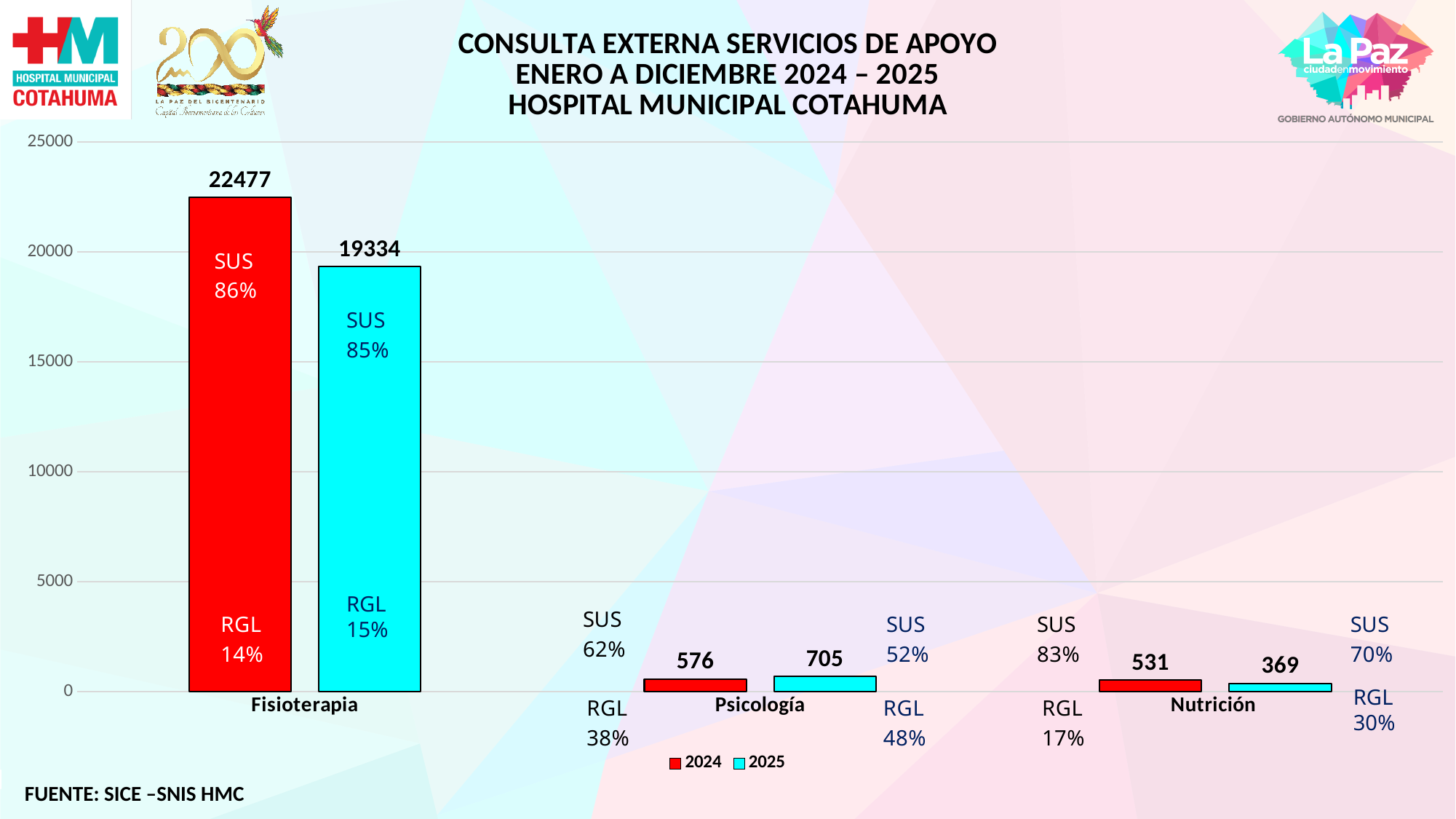
What is the value for Fisioterapia in 2024? 22477 Which category has the highest value in 2024? Fisioterapia Is the 2025 value for Fisioterapia greater or less than 20000? less Which is larger for Psicología, the 2024 value or the 2025 value? 2025 What is the difference between the 2024 and 2025 values for Fisioterapia? 3143 How many series does the legend list? 2 What is the value for Fisioterapia in 2025? 19334 What kind of chart is shown on the slide? bar chart What is the value for Nutrición in 2024? 531 What is the value for Psicología in 2025? 705 Which category has the lowest value in 2025? Nutrición How many categories are shown on the x axis? 3